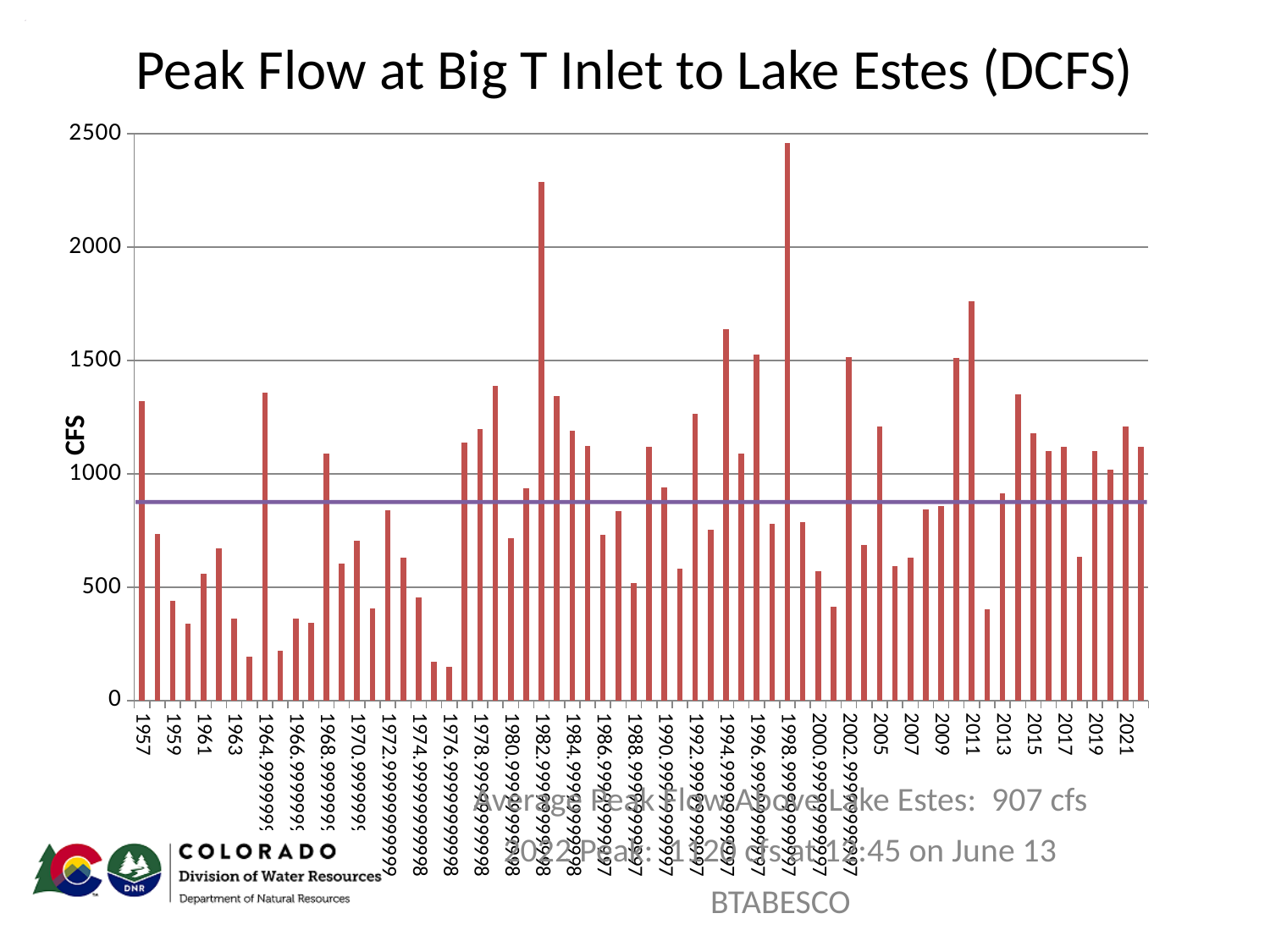
Which year has the larger peak flow, 1957 or 1958? 1957 Which year has the larger peak flow, 1982 or 1998? 1998 What label is shown on the vertical axis of the chart? CFS Is the peak flow value for 1998 greater or less than 2000? greater Is the peak flow value for 1957 greater or less than 1000? greater What kind of chart is shown on the slide? bar chart According to the text on the slide, what was the 2022 peak flow? 1120 cfs Is the peak flow value for 1982 greater or less than 2000? greater What is the title of the chart? Peak Flow at Big T Inlet to Lake Estes (DCFS) Which year has the highest peak flow in the chart? 1998